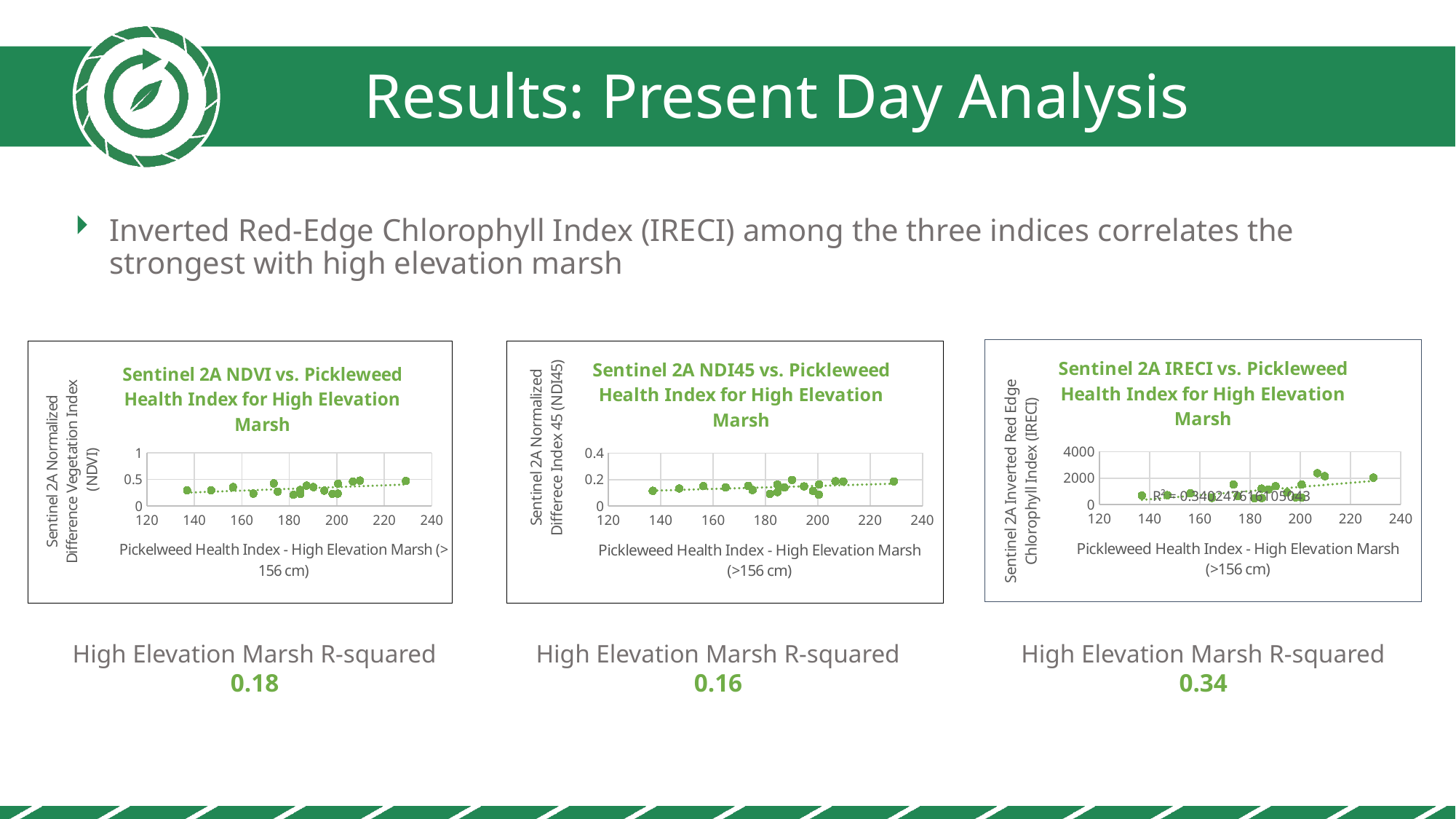
What kind of chart is the leftmost chart, 'Sentinel 2A NDVI vs. Pickleweed Health Index for High Elevation Marsh'? Scatter chart In the 'Sentinel 2A IRECI vs. Pickleweed Health Index for High Elevation Marsh' chart, is the highest plotted IRECI value greater or less than 4000? less Which of the three charts has the highest reported High Elevation Marsh R-squared value? Sentinel 2A IRECI vs. Pickleweed Health Index for High Elevation Marsh What is the difference between the R-squared value reported for the IRECI chart and the R-squared value reported for the NDVI chart? 0.16 What R-squared value is reported below the 'Sentinel 2A NDI45 vs. Pickleweed Health Index for High Elevation Marsh' chart? 0.16 In the 'Sentinel 2A IRECI vs. Pickleweed Health Index for High Elevation Marsh' chart, do the plotted values generally rise or fall as the Pickleweed Health Index increases? Rise How many charts are shown on the slide? 3 In the 'Sentinel 2A NDI45 vs. Pickleweed Health Index for High Elevation Marsh' chart, are all plotted NDI45 values greater or less than 0.4? less What is the highest x-axis tick value shown on the 'Sentinel 2A NDI45 vs. Pickleweed Health Index for High Elevation Marsh' chart? 240 What R-squared value is reported below the 'Sentinel 2A IRECI vs. Pickleweed Health Index for High Elevation Marsh' chart? 0.34 In the 'Sentinel 2A NDVI vs. Pickleweed Health Index for High Elevation Marsh' chart, are all plotted NDVI values greater or less than 1? less In the 'Sentinel 2A NDVI vs. Pickleweed Health Index for High Elevation Marsh' chart, does the trend line rise or fall along the x axis? Rise